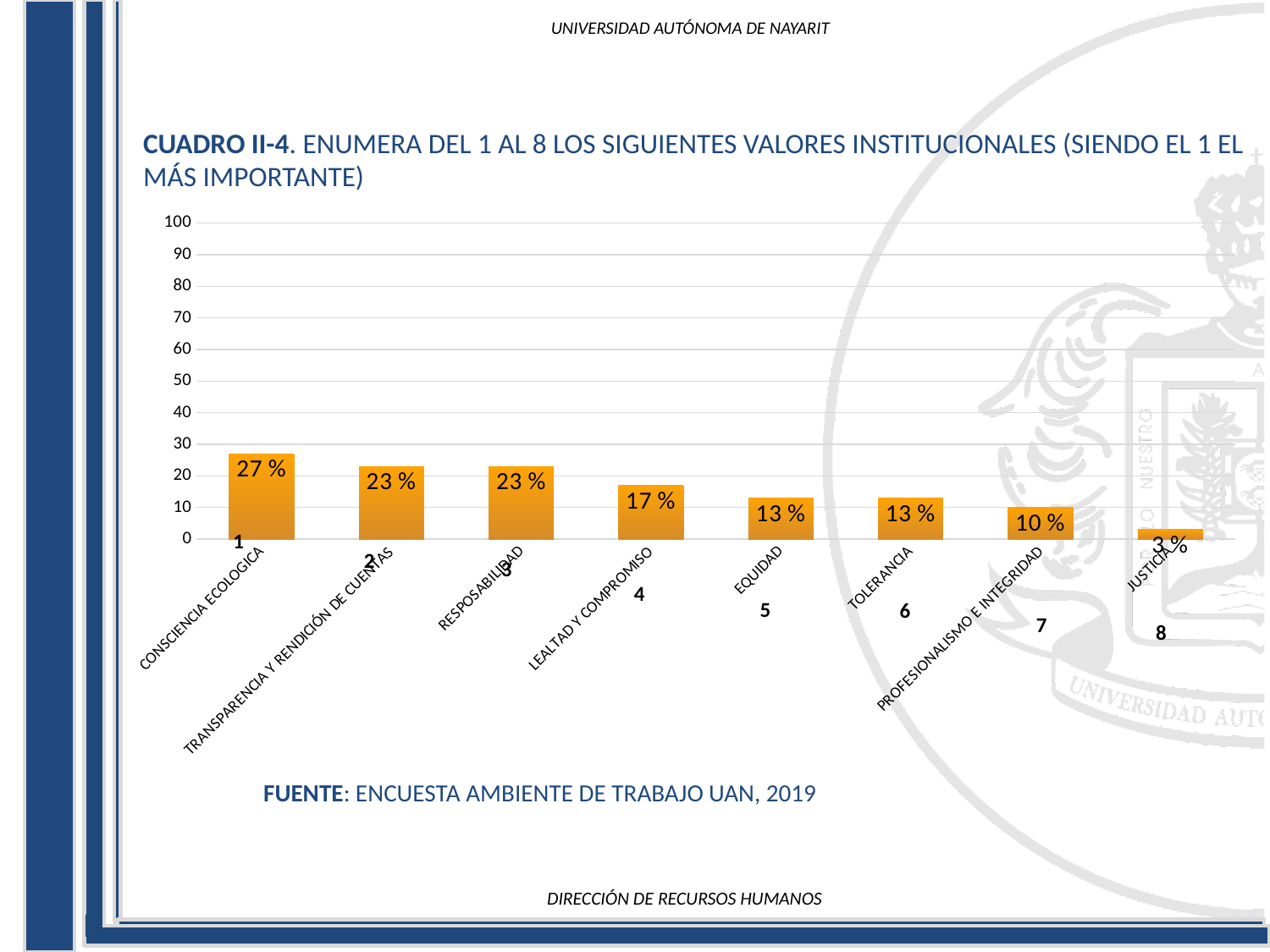
What is the value for JUSTICIA? 3 % How many categories are shown on the x axis? 8 What is the value for CONSCIENCIA ECOLOGICA? 27 % Which is larger, the value for EQUIDAD or the value for PROFESIONALISMO E INTEGRIDAD? EQUIDAD What is the value for PROFESIONALISMO E INTEGRIDAD? 10 % Is the value for TRANSPARENCIA Y RENDICIÓN DE CUENTAS greater or less than 30? less Which category has the highest value? CONSCIENCIA ECOLOGICA Which category has the lowest value? JUSTICIA Do the values rise or fall from left to right along the x axis? fall What is the value for LEALTAD Y COMPROMISO? 17 % What is the difference between the values for CONSCIENCIA ECOLOGICA and LEALTAD Y COMPROMISO? 10 % What kind of chart is shown on the slide? bar chart